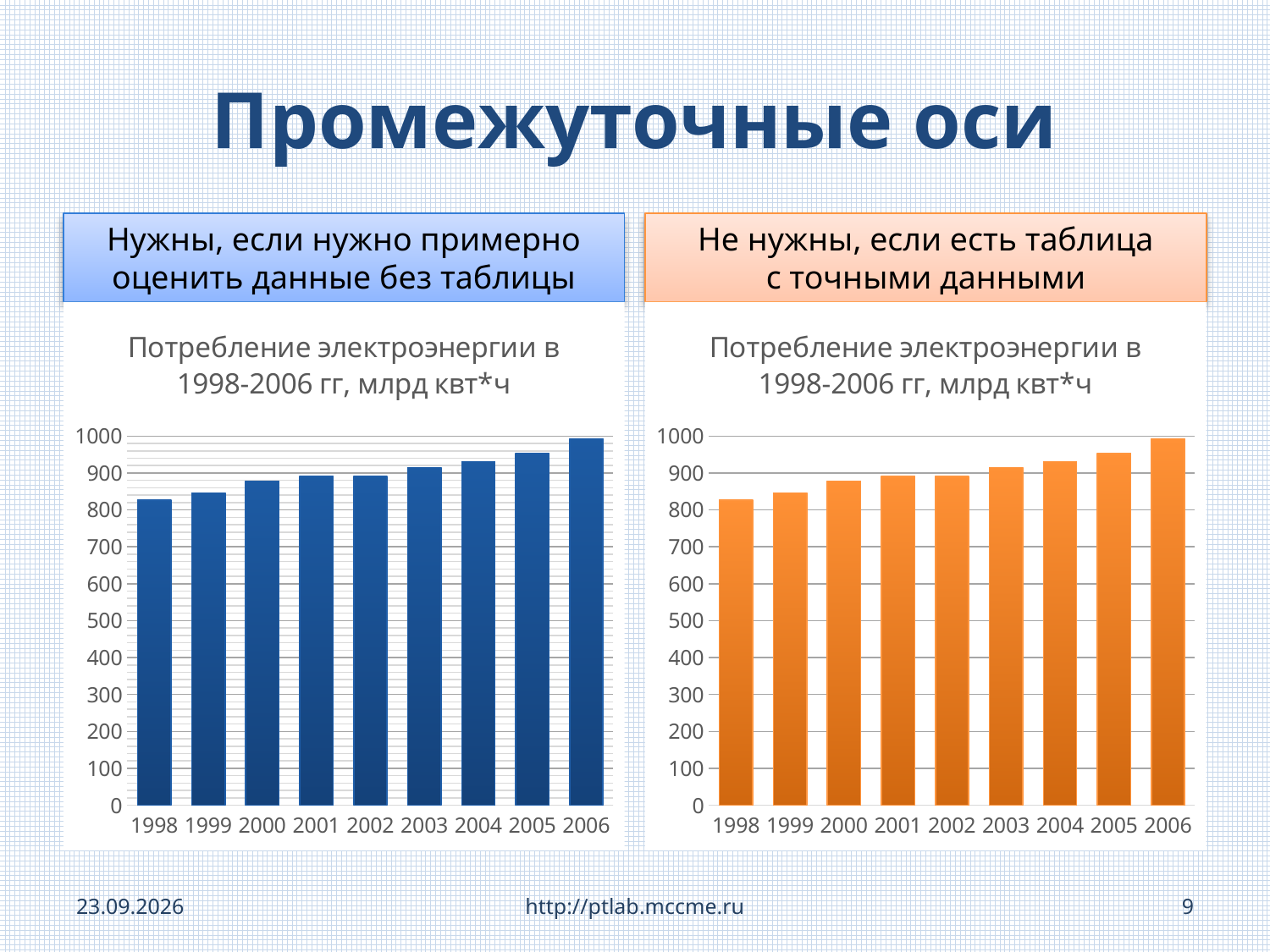
In the right chart, is the value for 2005 greater or less than 900? greater In the left chart, is the value for 2000 greater or less than 900? less How many years are shown on the x axis of the right chart? 9 In the left chart, which is larger, the value for 2005 or the value for 2003? 2005 In the left chart, which year has the highest electricity consumption? 2006 In the left chart, is the value for 1998 greater or less than 900? less What is the title of the right chart? Потребление электроэнергии в 1998-2006 гг, млрд квт*ч In the right chart, which year has the lowest electricity consumption? 1998 What colour are the bars in the left chart? blue What kind of chart is the left chart on the slide? bar chart Do the values in the right chart generally rise or fall from 1998 to 2006? rise